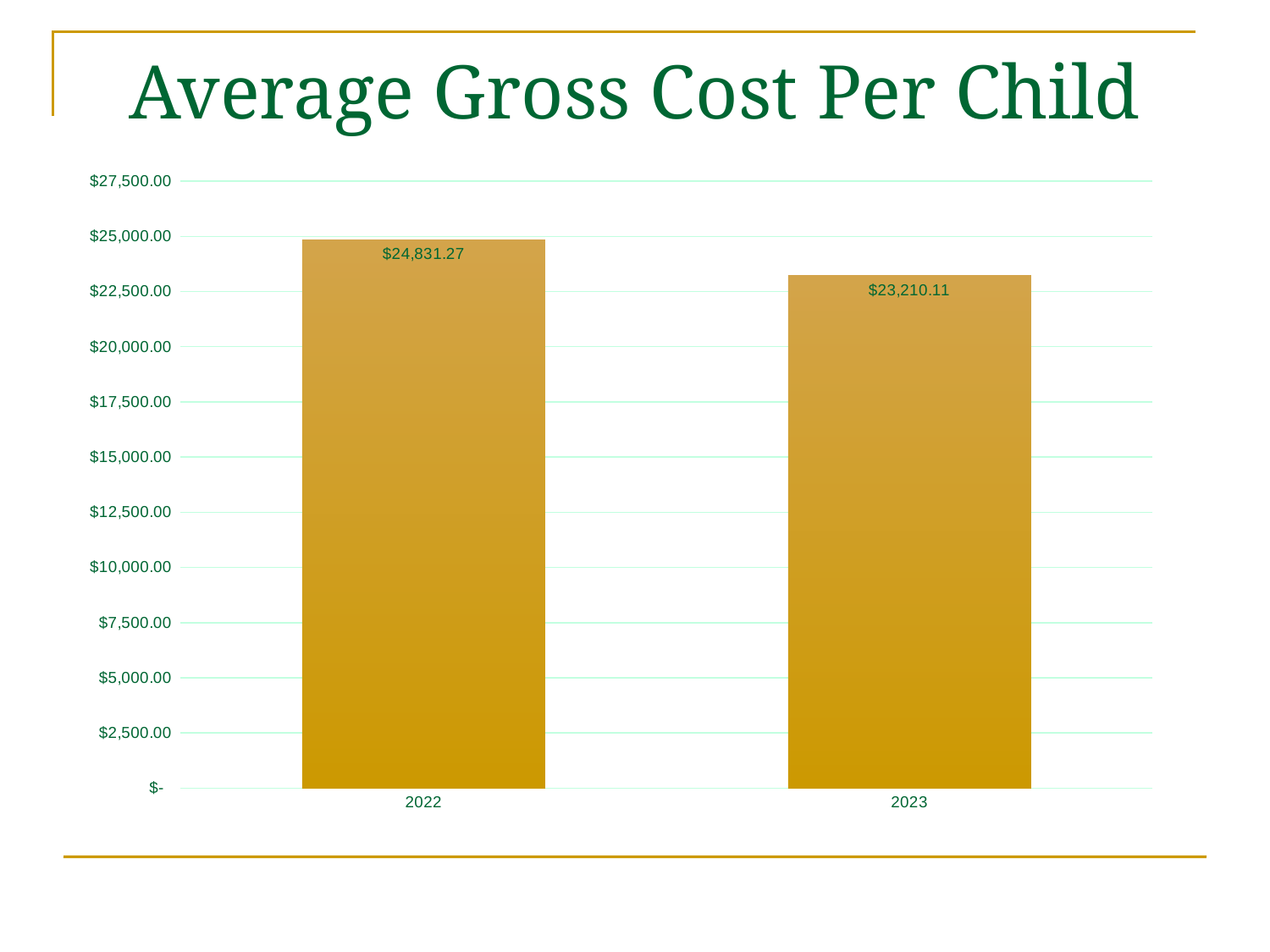
Does the average gross cost per child rise or fall from 2022 to 2023? fall What is the highest value labelled on the vertical axis? $27,500.00 What is the difference between the 2022 and 2023 average gross cost per child? $1,621.16 What is the title of the chart? Average Gross Cost Per Child Which year has the lower average gross cost per child? 2023 Is the value for 2022 greater or less than $25,000.00? less Which year has the higher average gross cost per child? 2022 How many years are shown on the chart? 2 Is the value for 2023 greater or less than $22,500.00? greater What kind of chart is shown on the slide? bar chart What is the average gross cost per child for 2022? $24,831.27 What is the average gross cost per child for 2023? $23,210.11